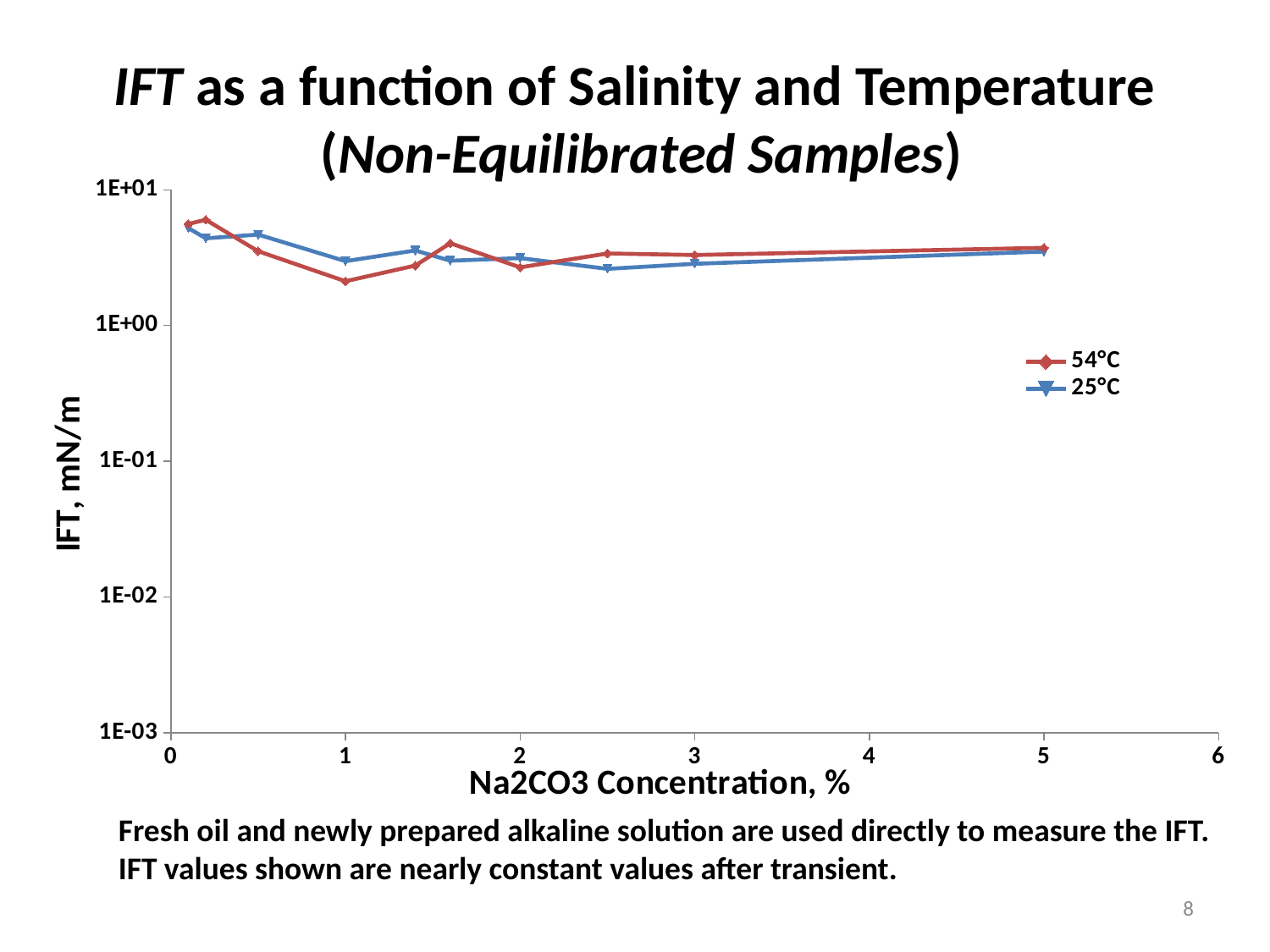
What is the label of the x axis? Na2CO3 Concentration, % What kind of chart is shown on the slide? line chart Is the IFT value for the 54°C series at 1% Na2CO3 greater or less than 1E+00? greater What is the highest tick value shown on the x axis? 6 How many series does the legend list? 2 Is the IFT value for the 25°C series at 5% Na2CO3 greater or less than 1E+01? less What are the two series named in the legend? 54°C and 25°C At 1% Na2CO3 concentration, which series has the higher IFT value, 54°C or 25°C? 25°C At 2.5% Na2CO3 concentration, which series has the higher IFT value, 54°C or 25°C? 54°C At which Na2CO3 concentration does the 54°C series reach its lowest IFT value? 1 Does the 54°C series rise or fall between 1% and 1.6% Na2CO3 concentration? rise Is the IFT value for the 25°C series at 0.1% Na2CO3 greater or less than 1E+00? greater